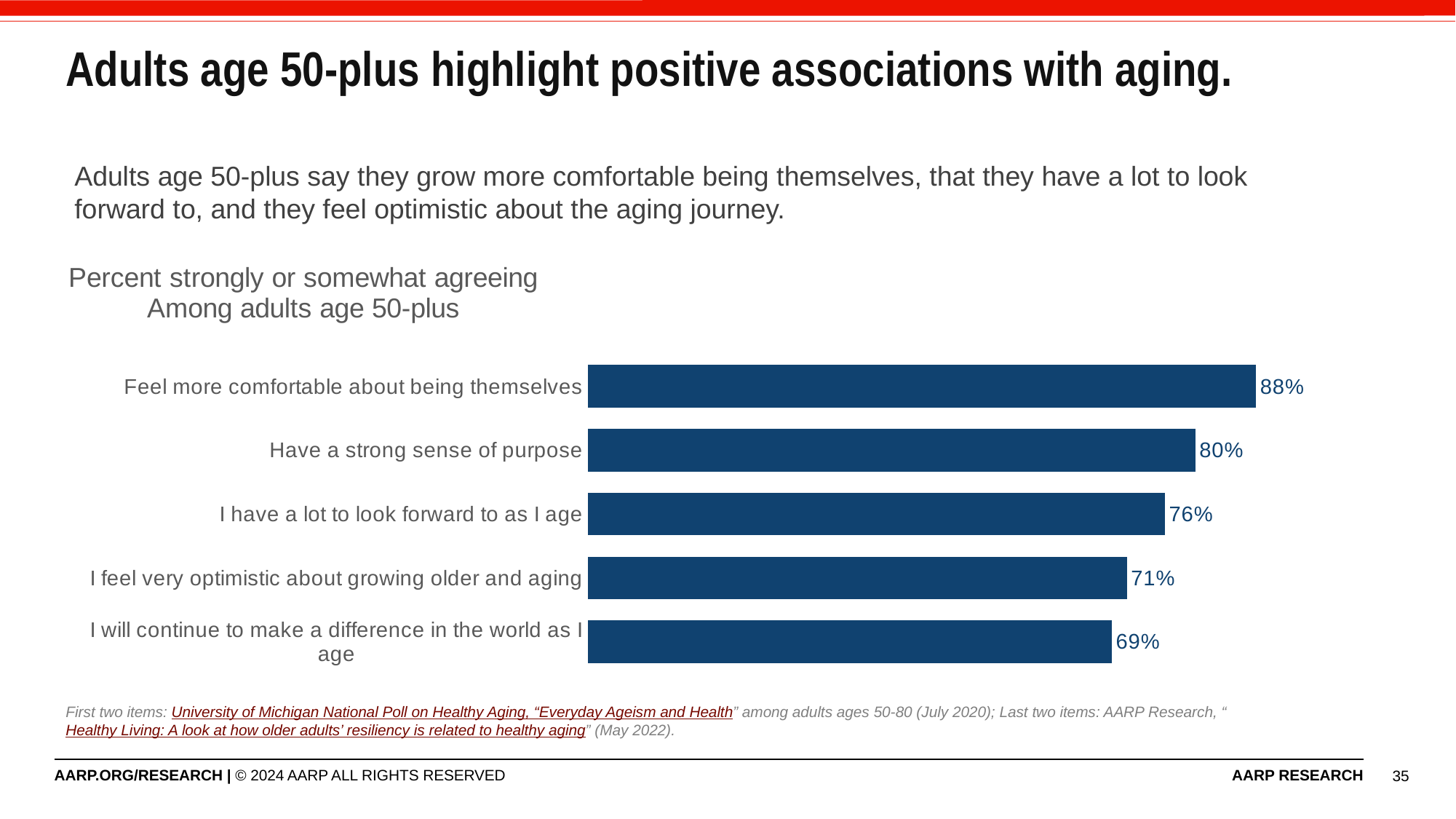
What percentage of adults age 50-plus agree they feel more comfortable about being themselves? 88% What is the difference in percentage points between 'Feel more comfortable about being themselves' and 'Have a strong sense of purpose'? 8 percentage points What percentage agree with 'I feel very optimistic about growing older and aging'? 71% How many statements are shown in the chart? 5 What percentage agree they have a strong sense of purpose? 80% What percentage agree with 'I have a lot to look forward to as I age'? 76% What percentage agree with 'I will continue to make a difference in the world as I age'? 69% What type of chart is shown on the slide? Bar chart Which statement has the lowest percentage agreeing? I will continue to make a difference in the world as I age Which statement has the highest percentage agreeing? Feel more comfortable about being themselves Which is larger: the percentage for 'I have a lot to look forward to as I age' or for 'I feel very optimistic about growing older and aging'? I have a lot to look forward to as I age What is the chart's title? Percent strongly or somewhat agreeing Among adults age 50-plus